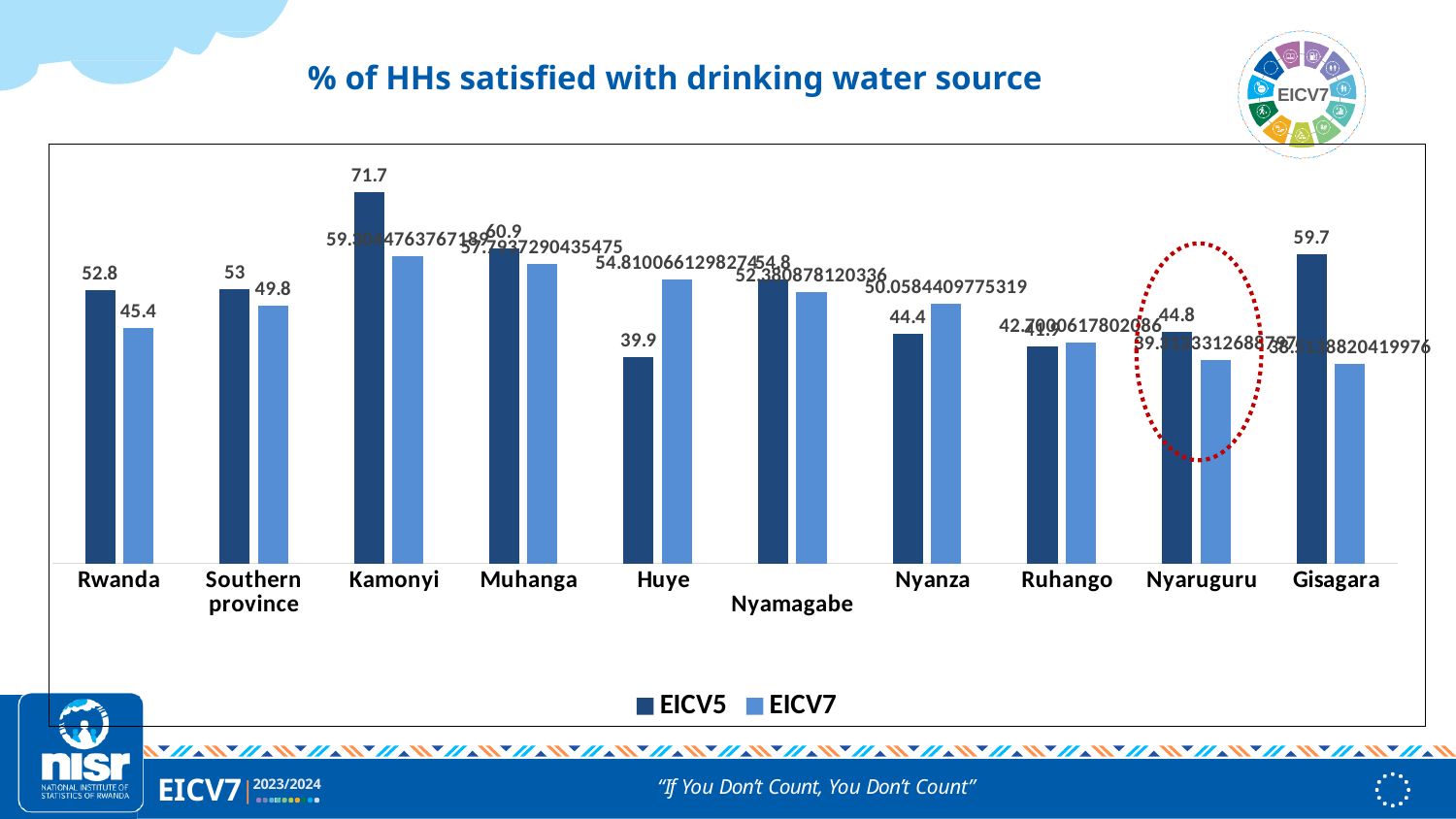
What is the difference between the EICV5 and EICV7 values for Southern province? 3.2 What is the EICV5 value for Rwanda? 52.8 Which category has the lowest EICV5 value? Huye What is the EICV7 value for Rwanda? 45.4 What is the EICV5 value for Kamonyi? 71.7 What is the difference between the EICV5 and EICV7 values for Rwanda? 7.4 What is the EICV5 value for Gisagara? 59.7 How many series does the legend list? 2 What type of chart is shown on the slide? Bar chart For Huye, which series has the larger value, EICV5 or EICV7? EICV7 How many categories are shown on the x axis? 10 Which category has the highest EICV5 value? Kamonyi